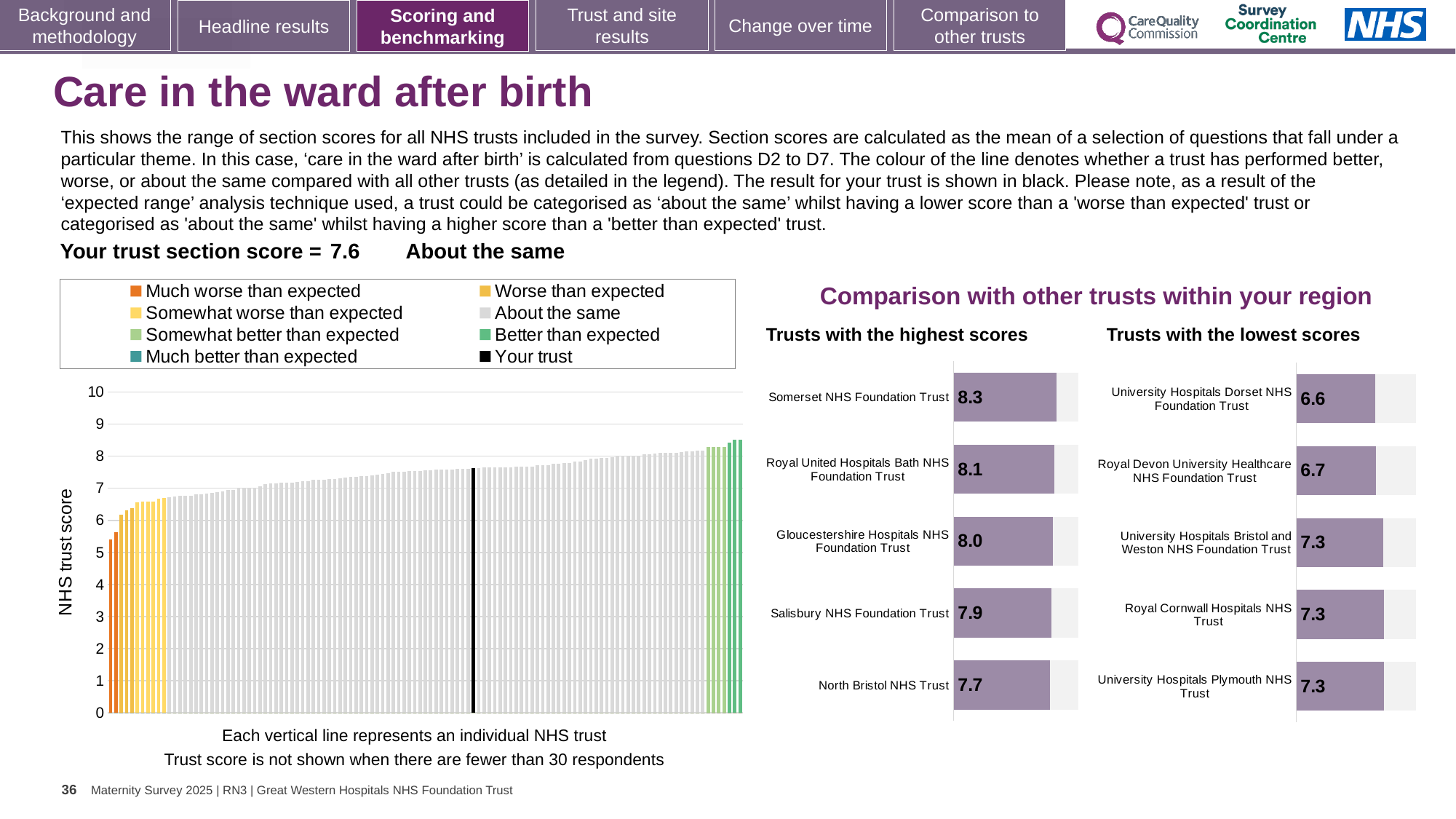
In the 'Trusts with the lowest scores' chart, what is the score for Royal Cornwall Hospitals NHS Trust? 7.3 In the large chart on the left, is the value for the black 'Your trust' bar greater or less than 7? greater In the 'Trusts with the lowest scores' chart, which trust has the lowest score? University Hospitals Dorset NHS Foundation Trust In the large chart on the left, do the trust scores rise or fall from left to right? Rise What kind of chart is the large chart on the left showing NHS trust scores? Bar chart In the 'Trusts with the lowest scores' chart, what is the score for Royal Devon University Healthcare NHS Foundation Trust? 6.7 How many entries does the legend of the large chart on the left list? 8 In the 'Trusts with the highest scores' chart, what is the score for Somerset NHS Foundation Trust? 8.3 In the 'Trusts with the highest scores' chart, what is the difference between the scores of Somerset NHS Foundation Trust and North Bristol NHS Trust? 0.6 In the 'Trusts with the highest scores' chart, which trust has the lowest score? North Bristol NHS Trust In the 'Trusts with the highest scores' chart, how many trusts are shown? 5 In the 'Trusts with the lowest scores' chart, which is larger: the score for Royal Devon University Healthcare NHS Foundation Trust or University Hospitals Dorset NHS Foundation Trust? Royal Devon University Healthcare NHS Foundation Trust